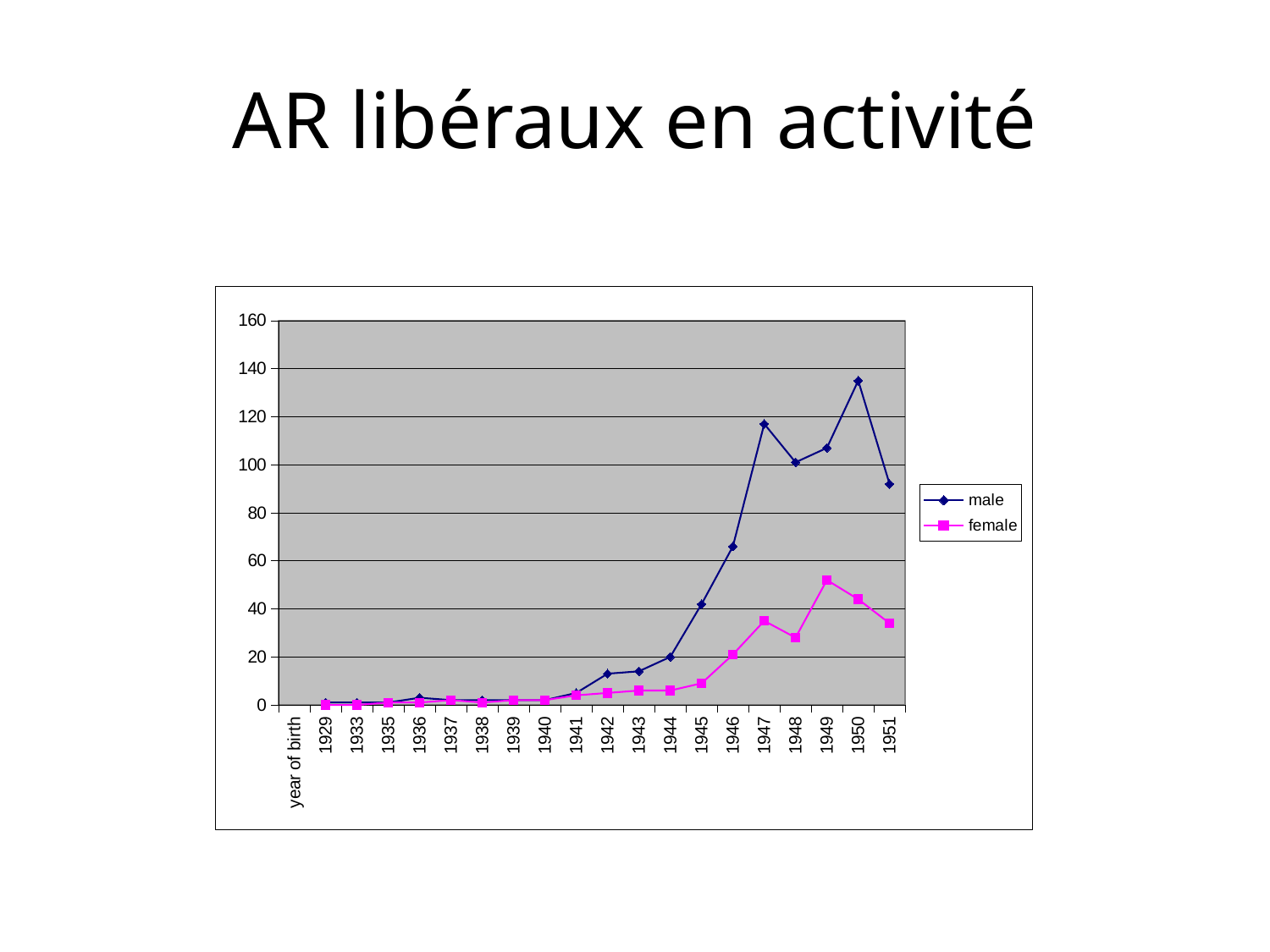
What kind of chart is shown on the slide? line chart Which series are listed in the legend? male, female In which year of birth does the female series reach its highest value? 1949 In which year of birth does the male series reach its highest value? 1950 Is the male value for 1947 greater or less than 100? greater Which series has the larger value for 1950, male or female? male Is the male value for 1946 greater or less than 60? greater Does the female series rise or fall from 1949 to 1951? fall How many series does the legend list? 2 Is the female value for 1947 greater or less than 40? less Does the male series rise or fall from 1941 to 1947? rise